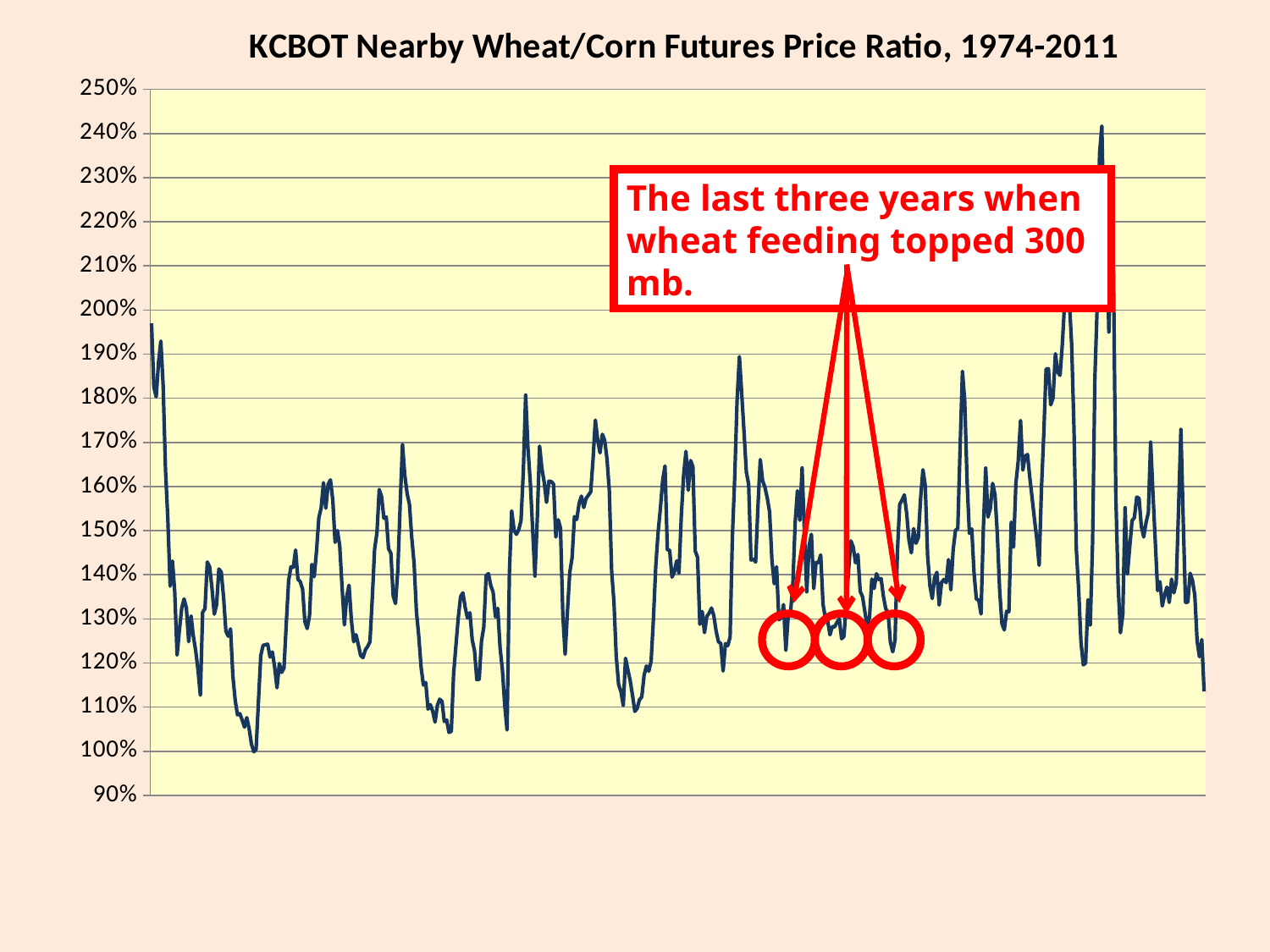
What does the red annotation box on the chart say? The last three years when wheat feeding topped 300 mb. How many points on the line are circled in red? 3 What is the highest value shown on the vertical axis? 250% Is the highest value reached by the line greater or less than 230%? greater What kind of chart is shown on the slide? line chart Is the value at the far right end of the line greater or less than 120%? less Is the lowest value reached by the line greater or less than 110%? less What is the title of the chart? KCBOT Nearby Wheat/Corn Futures Price Ratio, 1974-2011 What is the lowest value shown on the vertical axis? 90%